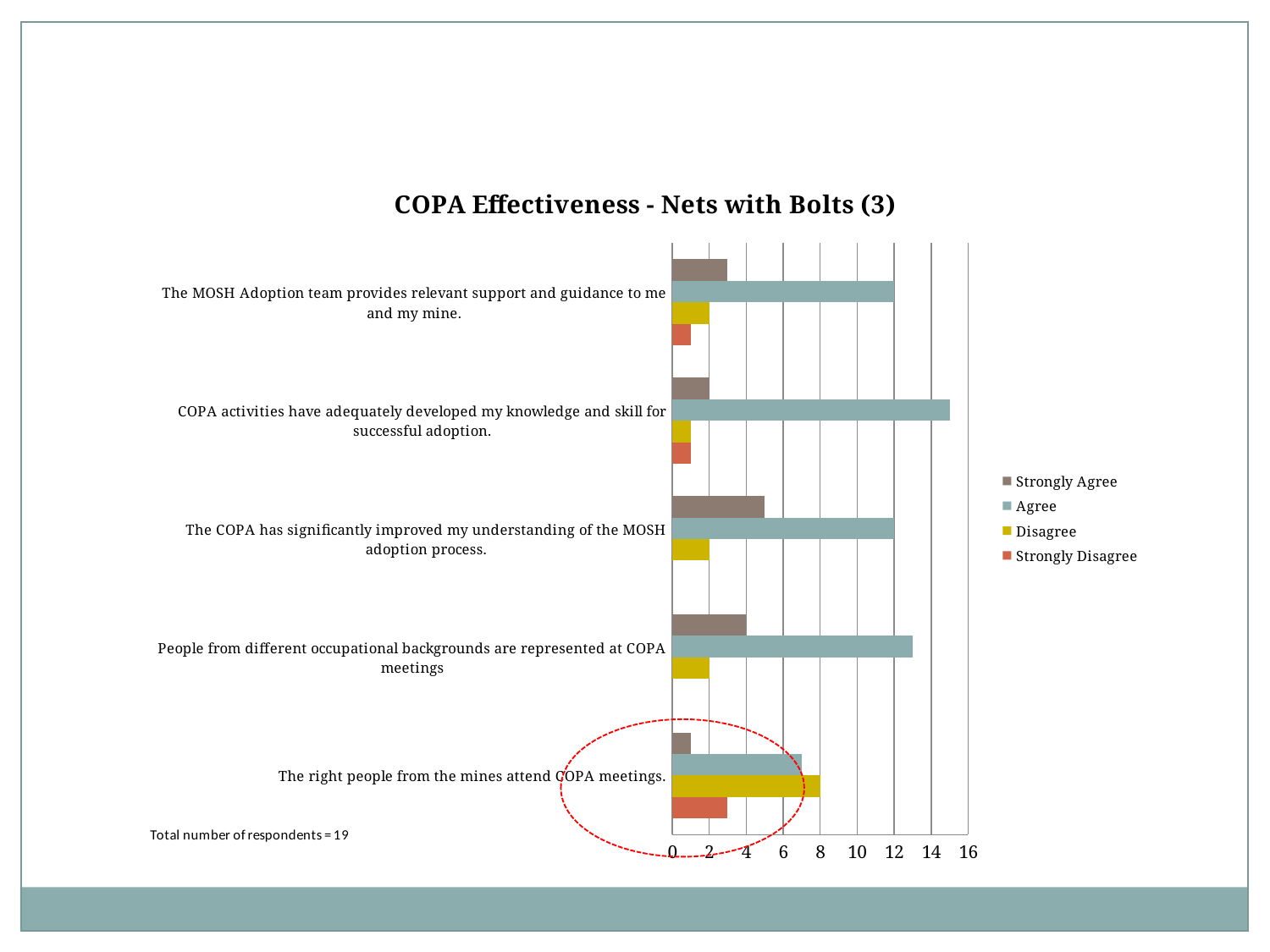
How many statements (categories) are plotted on the chart? 5 Which has the larger Strongly Agree value: "The COPA has significantly improved my understanding of the MOSH adoption process." or "The right people from the mines attend COPA meetings."? The COPA has significantly improved my understanding of the MOSH adoption process. What kind of chart is shown on the slide? Bar chart What is the title of the chart? COPA Effectiveness - Nets with Bolts (3) What is the Disagree value for "The right people from the mines attend COPA meetings."? 8 Is the Agree value for "COPA activities have adequately developed my knowledge and skill for successful adoption." greater or less than 14? greater What is the Agree value for "The MOSH Adoption team provides relevant support and guidance to me and my mine."? 12 How many series does the legend list? 4 Which statement has the lowest Agree value? The right people from the mines attend COPA meetings. Which statement has the highest Agree value? COPA activities have adequately developed my knowledge and skill for successful adoption. Is the Strongly Disagree value for "The right people from the mines attend COPA meetings." greater or less than 2? greater What is the Strongly Agree value for "People from different occupational backgrounds are represented at COPA meetings"? 4